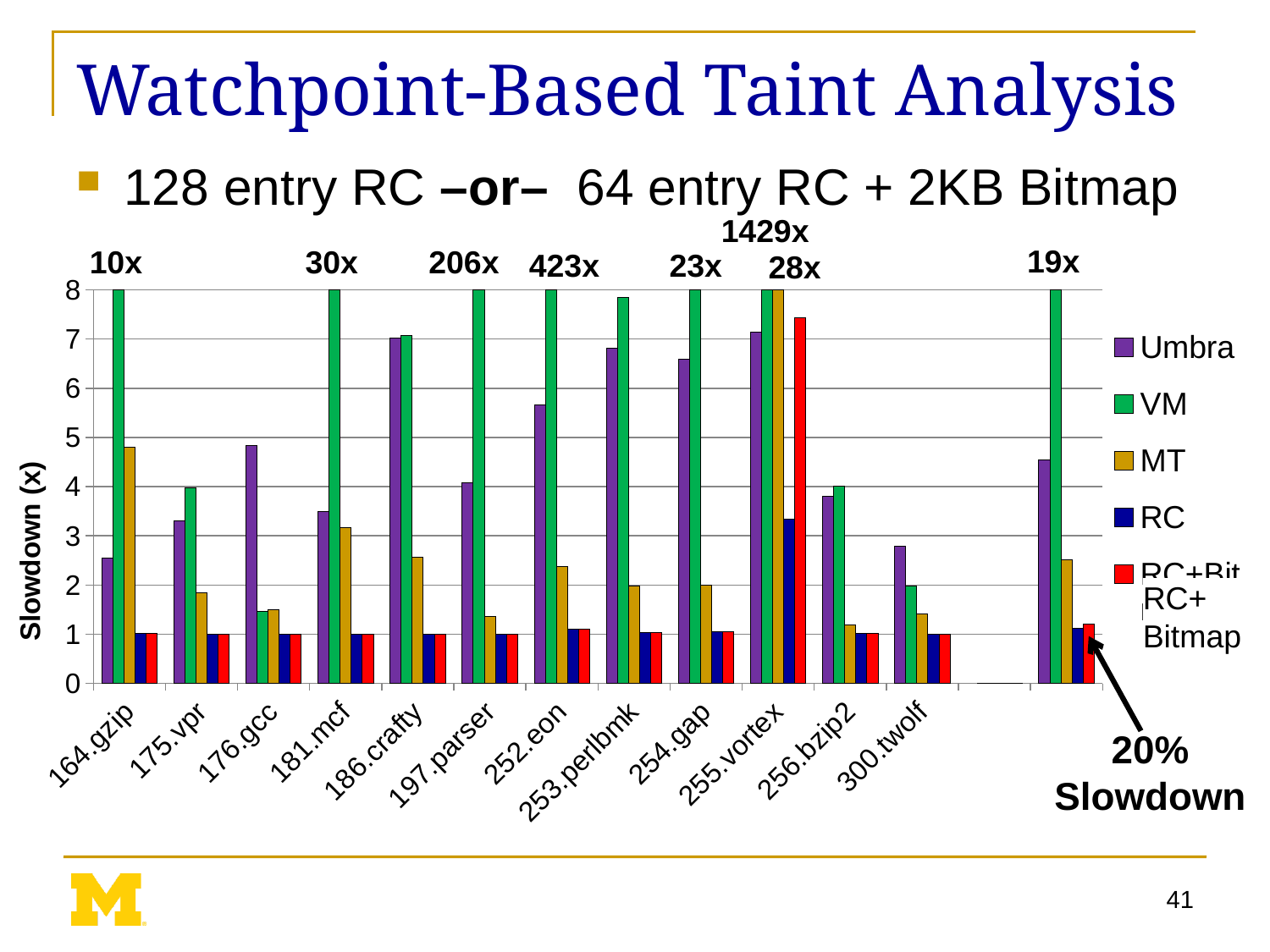
For 175.vpr, which is larger: the Umbra value or the VM value? VM Is the Umbra value for 164.gzip greater or less than 3? less What is the VM slowdown for 252.eon, as annotated above the chart? 423x Is the VM value for 176.gcc greater or less than 2? less Is the RC+Bit value for 255.vortex greater or less than 7? greater What is the VM slowdown for 164.gzip, as annotated above the chart? 10x What is the label on the y axis of the chart? Slowdown (x) What is the VM slowdown for 197.parser, as annotated above the chart? 206x What kind of chart is shown on the slide? bar chart How many benchmark categories are labeled on the x axis? 12 How many series does the chart's legend list? 5